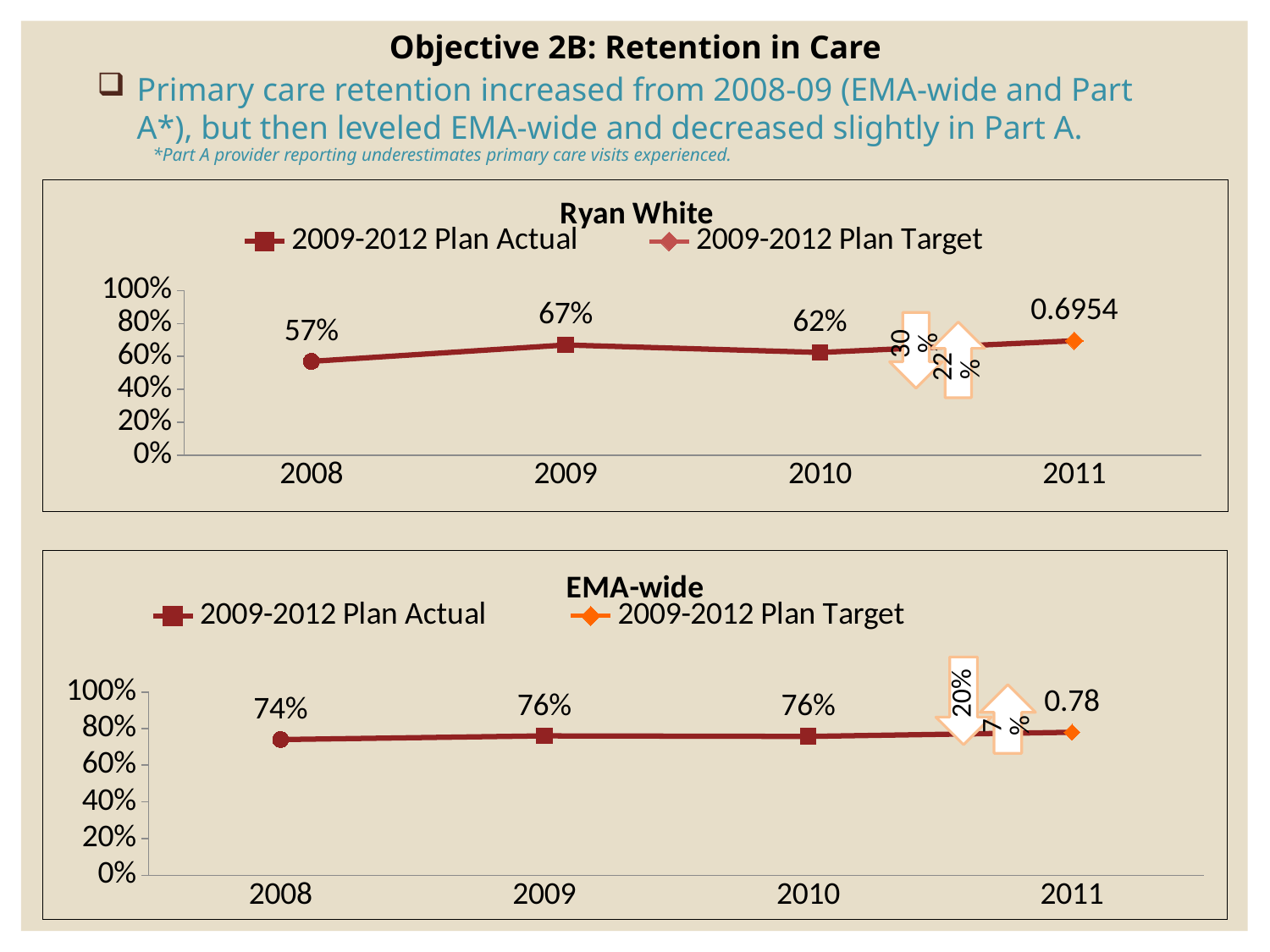
In the Ryan White chart, what is the difference between the 2009 and 2010 Plan Actual values? 5% In the Ryan White chart, which year has the lowest 2009-2012 Plan Actual value? 2008 In the EMA-wide chart, what is the 2009-2012 Plan Actual value for 2008? 74% In the EMA-wide chart, is the Plan Actual value for 2010 greater or less than 60%? greater In the Ryan White chart, what is the 2009-2012 Plan Actual value for 2008? 57% In the EMA-wide chart, what is the 2009-2012 Plan Target value shown for 2011? 0.78 In the EMA-wide chart, what is the difference between the 2009 and 2008 Plan Actual values? 2% What type of chart is the Ryan White chart? Line chart In the Ryan White chart, what is the 2009-2012 Plan Actual value for 2009? 67% In the Ryan White chart, which year has the highest 2009-2012 Plan Actual value? 2011 How many series does the legend of the EMA-wide chart list? 2